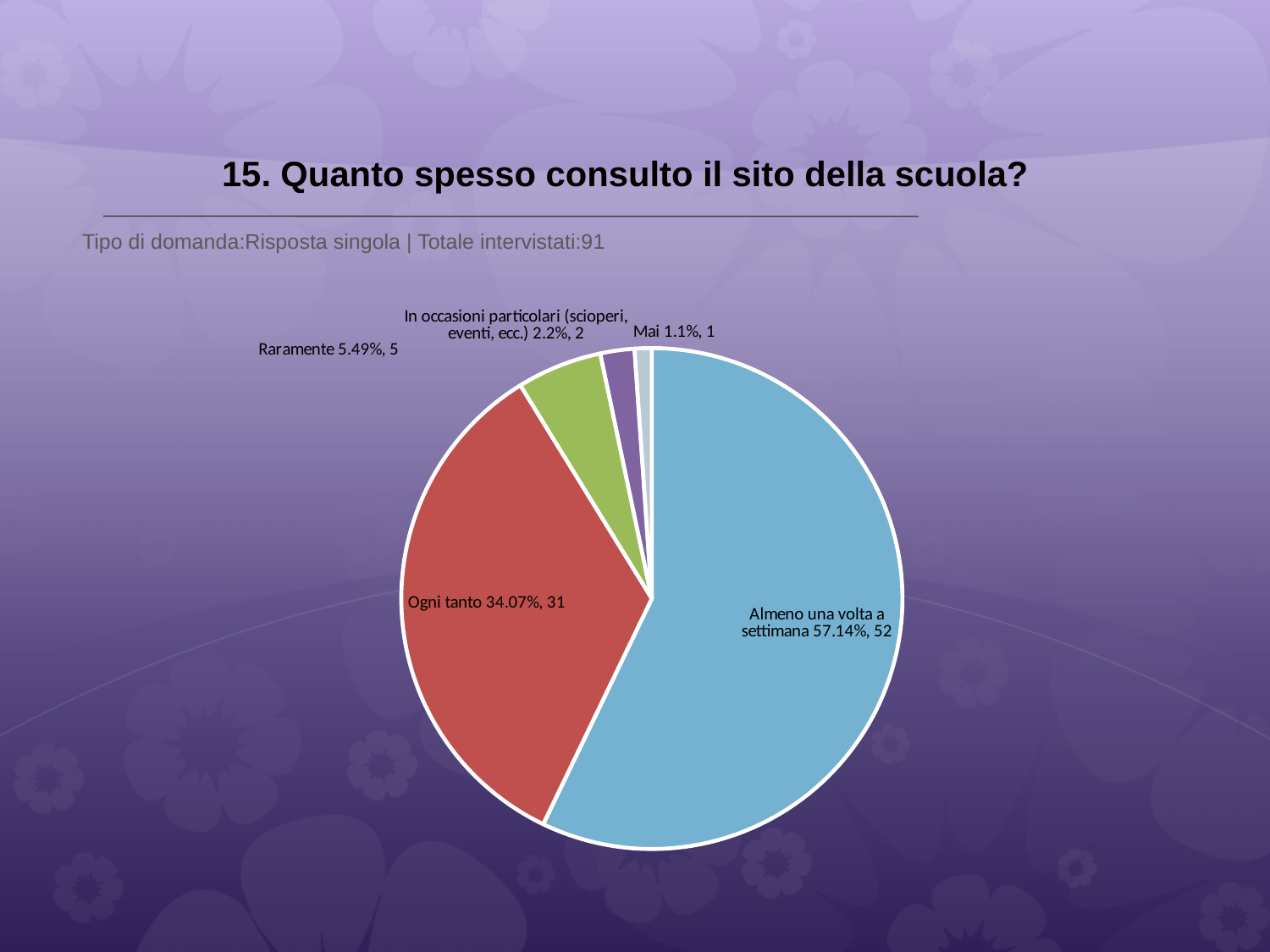
How many respondents chose 'Ogni tanto'? 31 What kind of chart is shown on the slide? pie chart Which has more respondents, 'Raramente' or 'Mai'? Raramente Which category has the smallest slice? Mai How many slices does the pie chart have? 5 What percentage share does the 'Almeno una volta a settimana' slice have? 57.14% What colour is the 'Ogni tanto' slice? red Which category has the largest slice? Almeno una volta a settimana What is the title of the chart? 15. Quanto spesso consulto il sito della scuola? How many respondents chose 'In occasioni particolari (scioperi, eventi, ecc.)'? 2 What is the difference in respondent count between 'Almeno una volta a settimana' and 'Ogni tanto'? 21 What percentage share does the 'Raramente' slice have? 5.49%